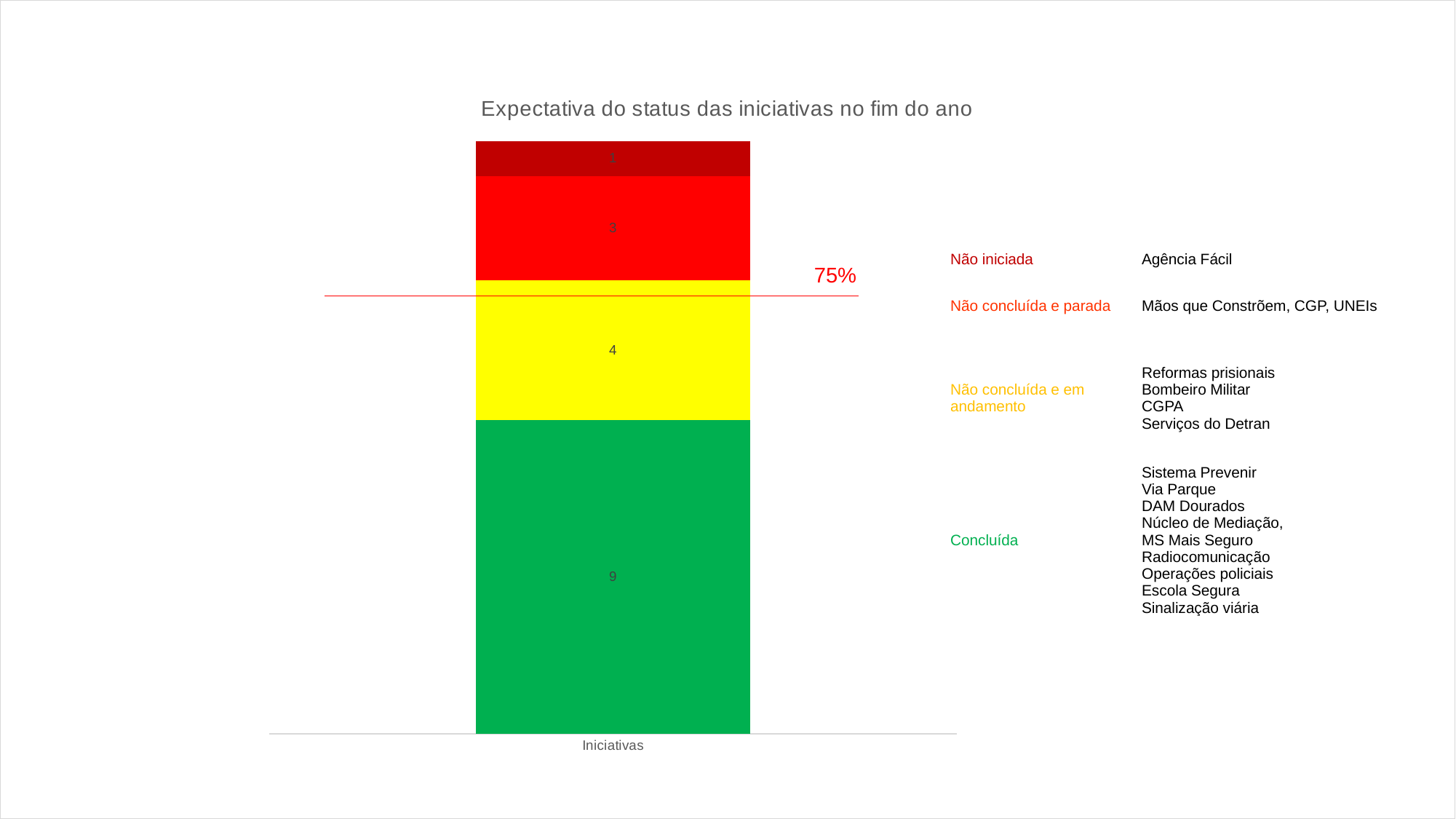
What is the title of the chart? Expectativa do status das iniciativas no fim do ano What is the total of all segments in the stacked bar? 17 Which status segment has the largest value in the bar? Concluída Which is larger, the Não concluída e parada segment or the Não concluída e em andamento segment? Não concluída e em andamento What is the value of the green (Concluída) segment of the bar? 9 What kind of chart is shown on the slide? Stacked bar chart What is the difference between the Concluída segment and the Não concluída e em andamento segment? 5 What is the value of the red (Não concluída e parada) segment of the bar? 3 What is the value of the dark red (Não iniciada) segment at the top of the bar? 1 What percentage is marked by the horizontal red line across the chart? 75% What is the value of the yellow (Não concluída e em andamento) segment of the bar? 4 Which status segment has the smallest value in the bar? Não iniciada